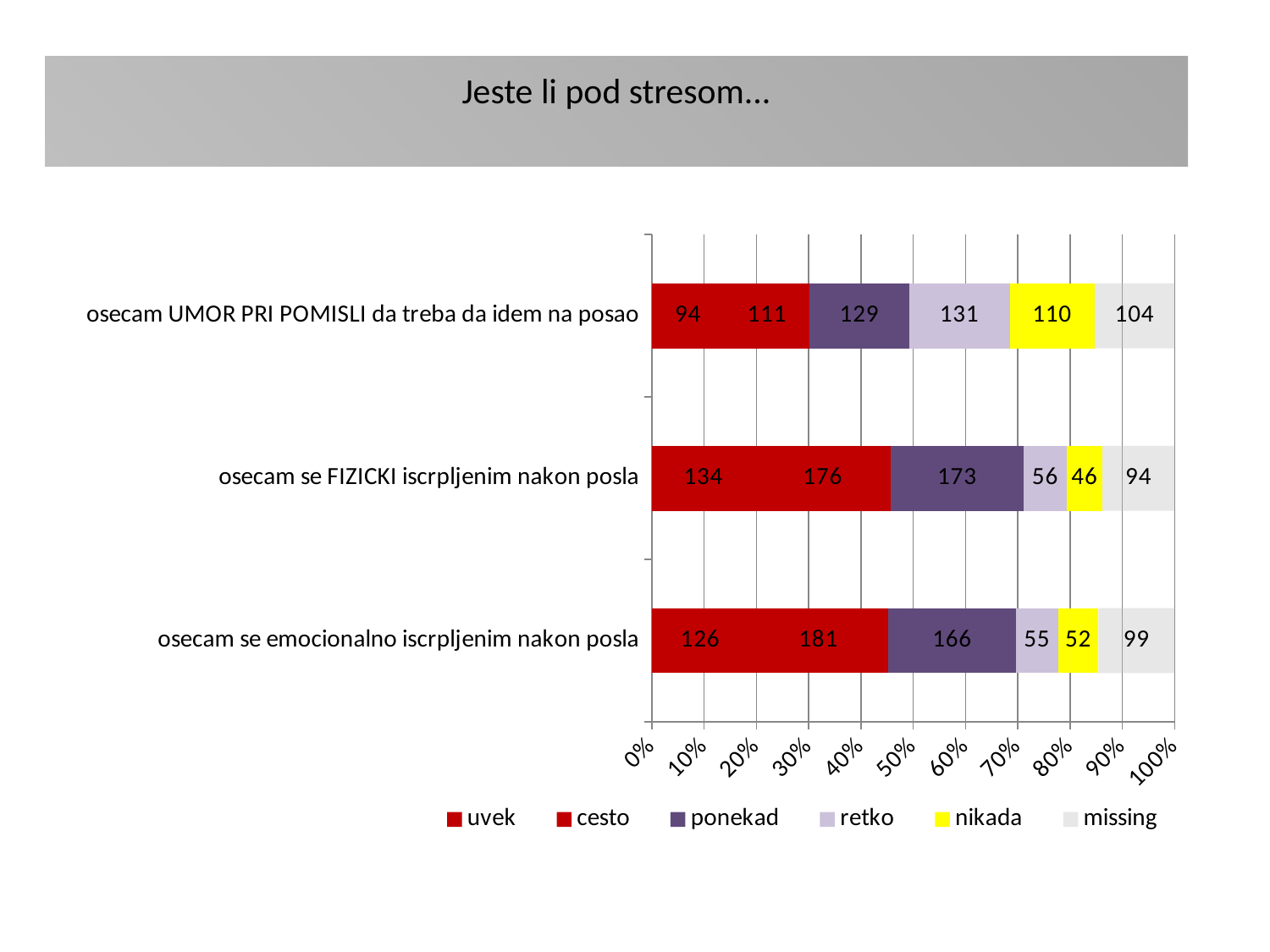
Which series has the lowest value in the bar 'osecam se FIZICKI iscrpljenim nakon posla'? nikada How many series does the legend list? 6 What is the total of all segments in the bar 'osecam se emocionalno iscrpljenim nakon posla'? 679 What is the difference between the 'cesto' value and the 'uvek' value in the bar 'osecam se emocionalno iscrpljenim nakon posla'? 55 Which is larger: the 'retko' value for 'osecam UMOR PRI POMISLI da treba da idem na posao' or the 'retko' value for 'osecam se FIZICKI iscrpljenim nakon posla'? osecam UMOR PRI POMISLI da treba da idem na posao What is the value for 'nikada' in the bar 'osecam UMOR PRI POMISLI da treba da idem na posao'? 110 What is the value for 'missing' in the bar 'osecam se FIZICKI iscrpljenim nakon posla'? 94 What is the value for 'cesto' in the bar 'osecam se emocionalno iscrpljenim nakon posla'? 181 What kind of chart is shown on the slide? stacked bar chart Which series has the highest value in the bar 'osecam UMOR PRI POMISLI da treba da idem na posao'? retko What is the value for 'ponekad' in the bar 'osecam se FIZICKI iscrpljenim nakon posla'? 173 How many categories (bars) are shown in the chart? 3